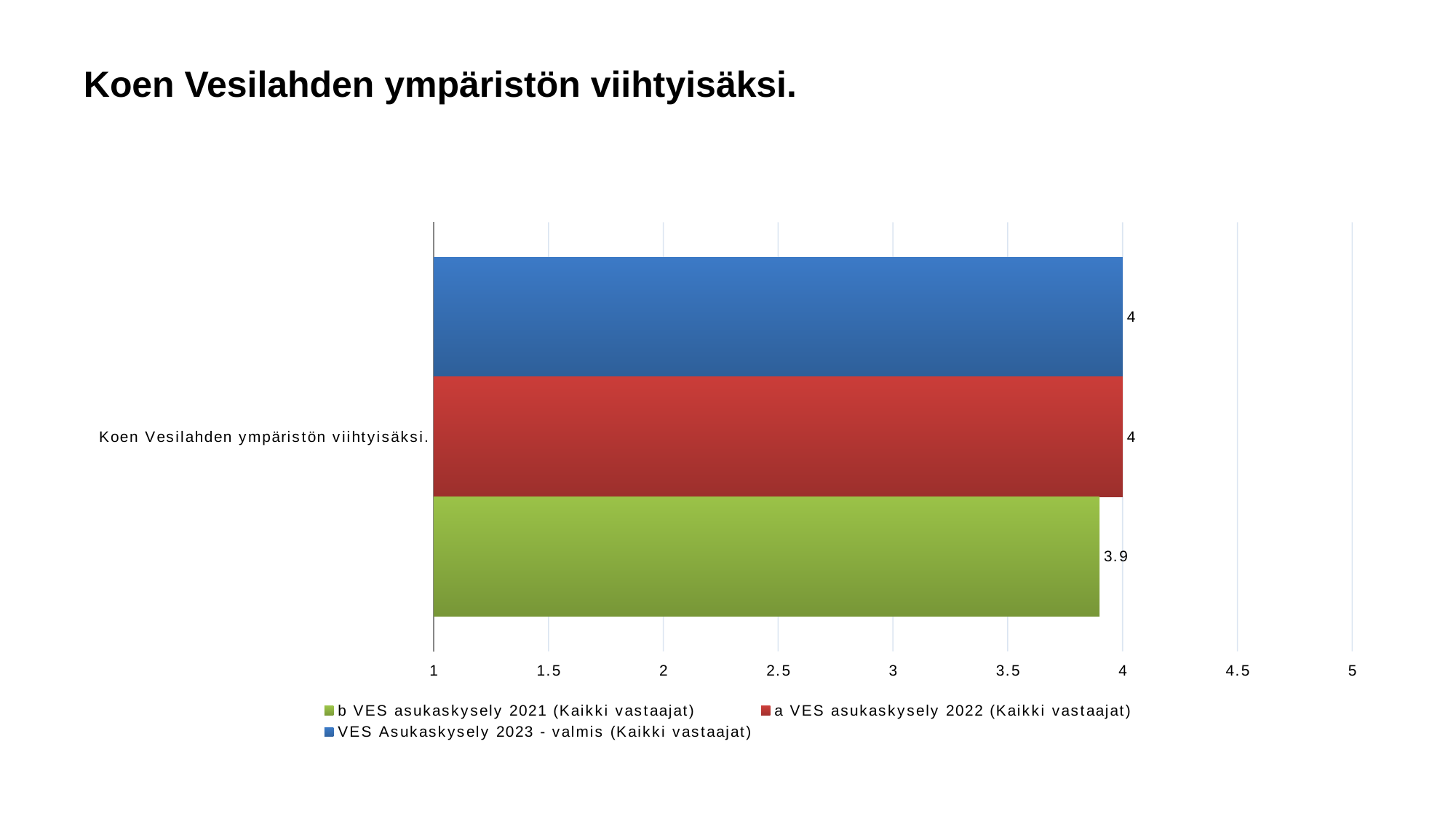
Which is larger: the value for 'VES Asukaskysely 2023 - valmis (Kaikki vastaajat)' or the value for 'b VES asukaskysely 2021 (Kaikki vastaajat)'? VES Asukaskysely 2023 - valmis (Kaikki vastaajat) What is the title of the chart? Koen Vesilahden ympäristön viihtyisäksi. What kind of chart is shown on the slide? bar chart What is the value for the series 'a VES asukaskysely 2022 (Kaikki vastaajat)'? 4 How many categories are shown on the vertical axis? 1 Is the value for 'b VES asukaskysely 2021 (Kaikki vastaajat)' greater or less than 3.5? greater What colour is the bar for 'a VES asukaskysely 2022 (Kaikki vastaajat)'? red Which series has the lowest value? b VES asukaskysely 2021 (Kaikki vastaajat) How many series does the legend list? 3 What is the value for the series 'VES Asukaskysely 2023 - valmis (Kaikki vastaajat)'? 4 What is the value for the series 'b VES asukaskysely 2021 (Kaikki vastaajat)'? 3.9 What is the difference between the value for 'a VES asukaskysely 2022 (Kaikki vastaajat)' and the value for 'b VES asukaskysely 2021 (Kaikki vastaajat)'? 0.1